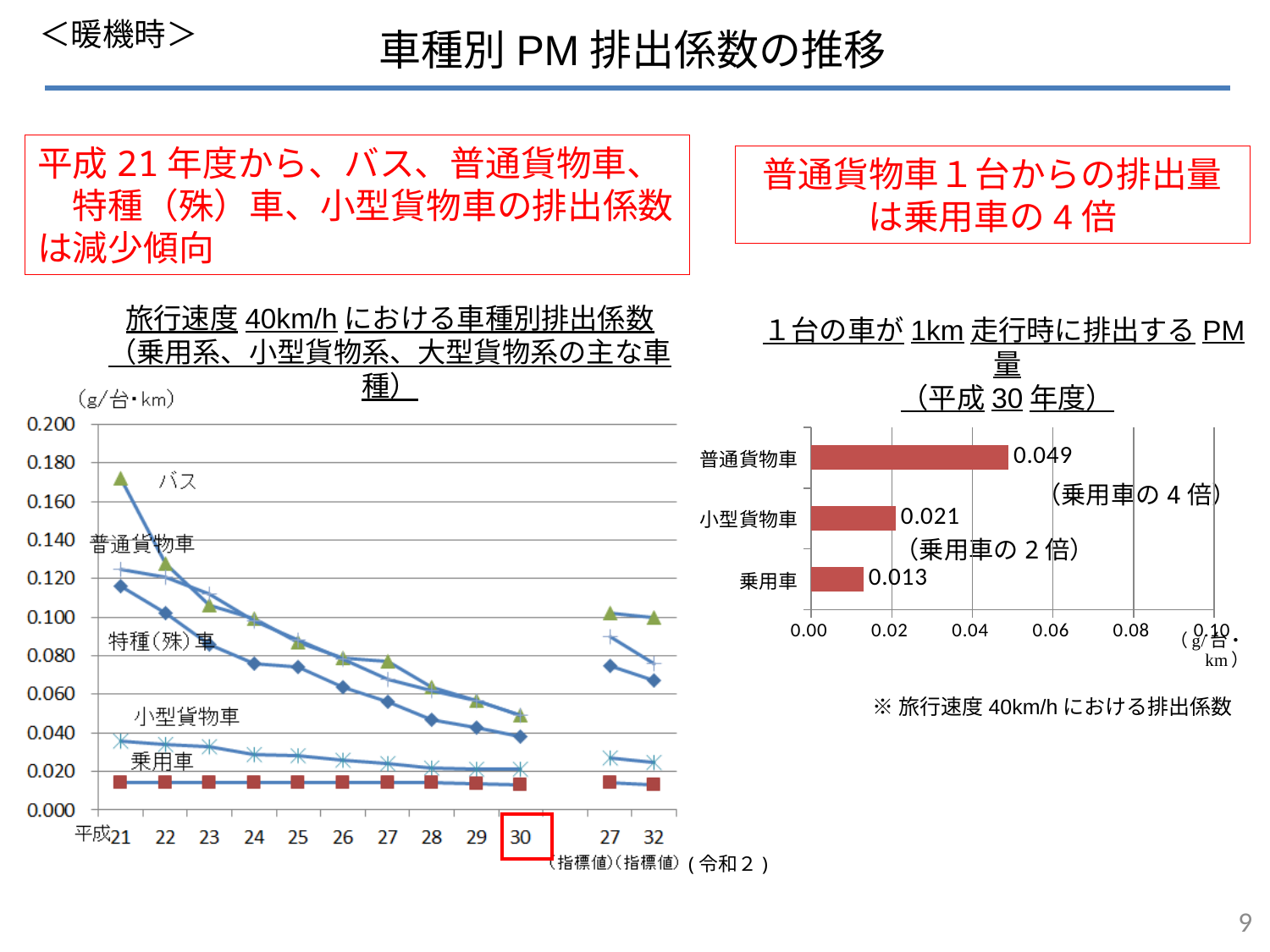
In the bar chart on the right, which vehicle type has the lowest PM emission value? 乗用車 In the bar chart on the right, how many vehicle categories are shown? 3 In the bar chart on the right, which vehicle type has the highest PM emission value? 普通貨物車 In the line chart on the left, is the value for バス in 平成21 greater or less than 0.160? greater What kind of chart is the chart on the right side of the slide? Bar chart In the bar chart on the right, what is the value for 小型貨物車? 0.021 What kind of chart is the chart on the left side of the slide (旅行速度40km/hにおける車種別排出係数)? Line chart In the line chart on the left, does the value for バス rise or fall from 平成21 to 平成30? Fall In the line chart on the left, is the value for 乗用車 in 平成30 greater or less than 0.020? less In the bar chart on the right, what is the value for 乗用車? 0.013 In the bar chart on the right, what is the difference between the values for 普通貨物車 and 乗用車? 0.036 In the bar chart on the right (1台の車が1km走行時に排出するPM量), what is the value for 普通貨物車? 0.049